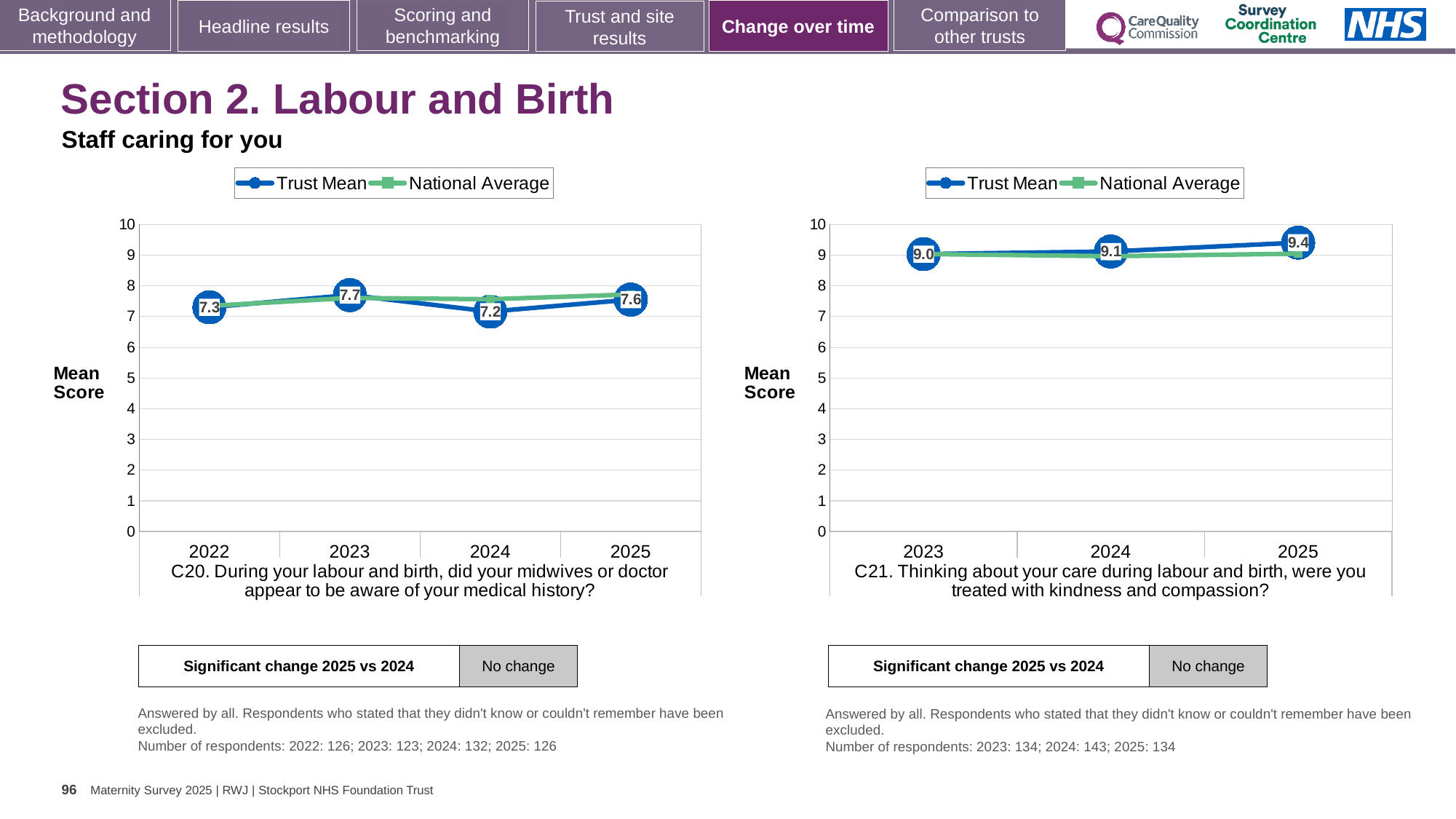
In the C20 chart (left), which year has the lowest Trust Mean? 2024 In the C21 chart (right), what is the Trust Mean for 2025? 9.4 In the C21 chart (right), what is the difference between the Trust Mean for 2025 and 2023? 0.4 In the C20 chart (left), what is the Trust Mean for 2023? 7.7 What type of chart is the C21 chart (right)? Line chart In the C20 chart (left), what is the difference between the Trust Mean for 2023 and 2024? 0.5 In the C21 chart (right), is the National Average for 2024 greater or less than 8? greater How many years are shown on the x axis of the C20 chart (left)? 4 In the C20 chart (left), what is the Trust Mean for 2024? 7.2 In the C20 chart (left), is the Trust Mean higher in 2022 or 2025? 2025 In the C21 chart (right), which year has the highest Trust Mean? 2025 How many series does the legend of the C21 chart (right) list? 2